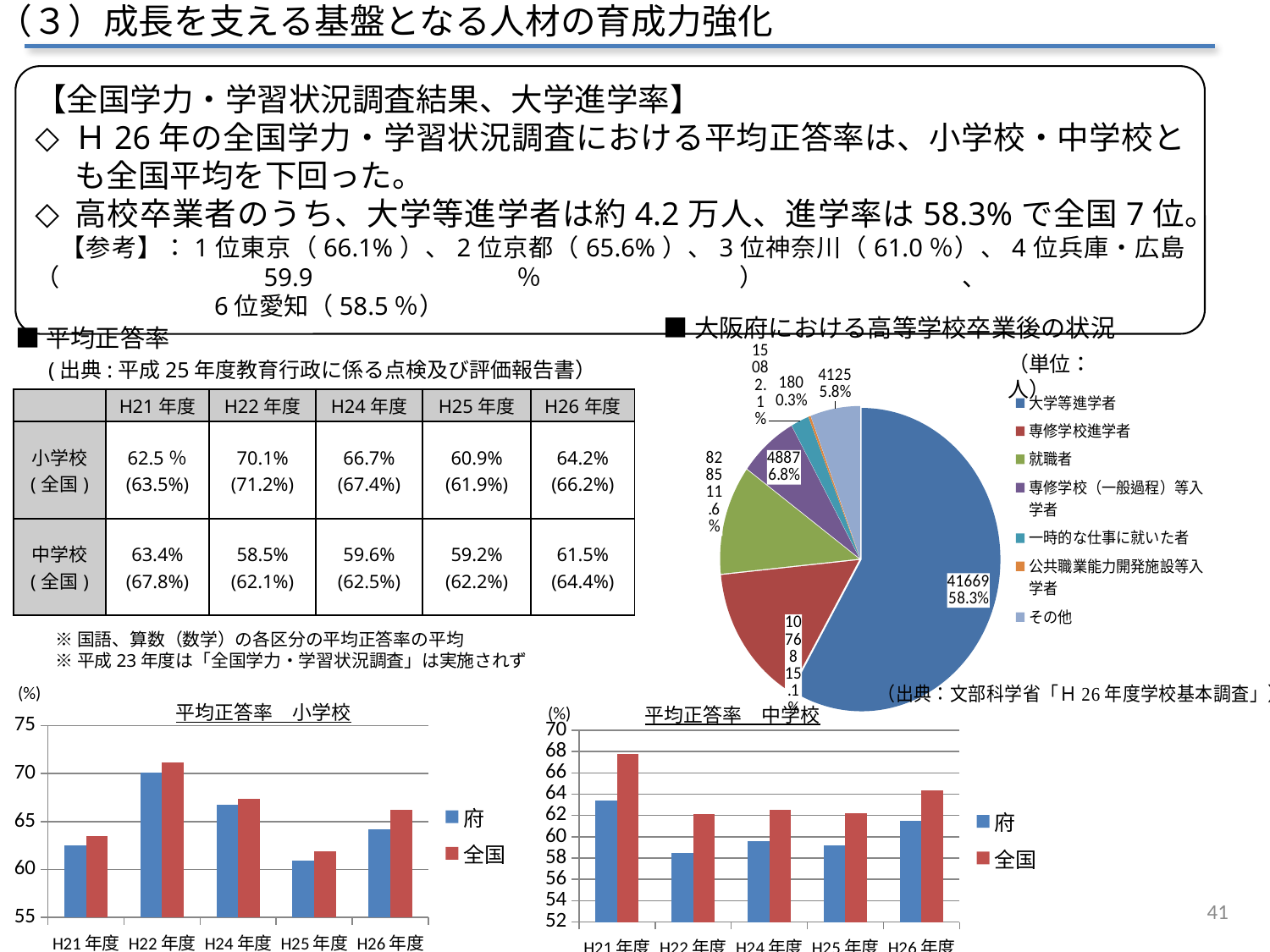
On the pie chart 大阪府における高等学校卒業後の状況, which category has the smallest slice? 公共職業能力開発施設等入学者 On the 平均正答率 小学校 chart, in which year is the 府 bar highest? H22年度 How many year categories are shown on the x axis of the 平均正答率 小学校 chart? 5 On the 平均正答率 小学校 chart, is the 全国 value for H22年度 greater or less than 70? greater On the pie chart 大阪府における高等学校卒業後の状況, what percentage is shown for 就職者? 11.6% On the pie chart 大阪府における高等学校卒業後の状況, what value is shown for 大学等進学者? 41669 On the 平均正答率 中学校 chart, in which year is the 全国 bar highest? H21年度 How many entries does the legend of the pie chart 大阪府における高等学校卒業後の状況 list? 7 What kind of chart is 平均正答率 小学校 at the bottom left of the slide? bar chart On the pie chart 大阪府における高等学校卒業後の状況, what value is shown for その他? 4125 On the 平均正答率 中学校 chart, which is larger for H26年度, 府 or 全国? 全国 On the pie chart 大阪府における高等学校卒業後の状況, what percentage share is shown for 大学等進学者? 58.3%